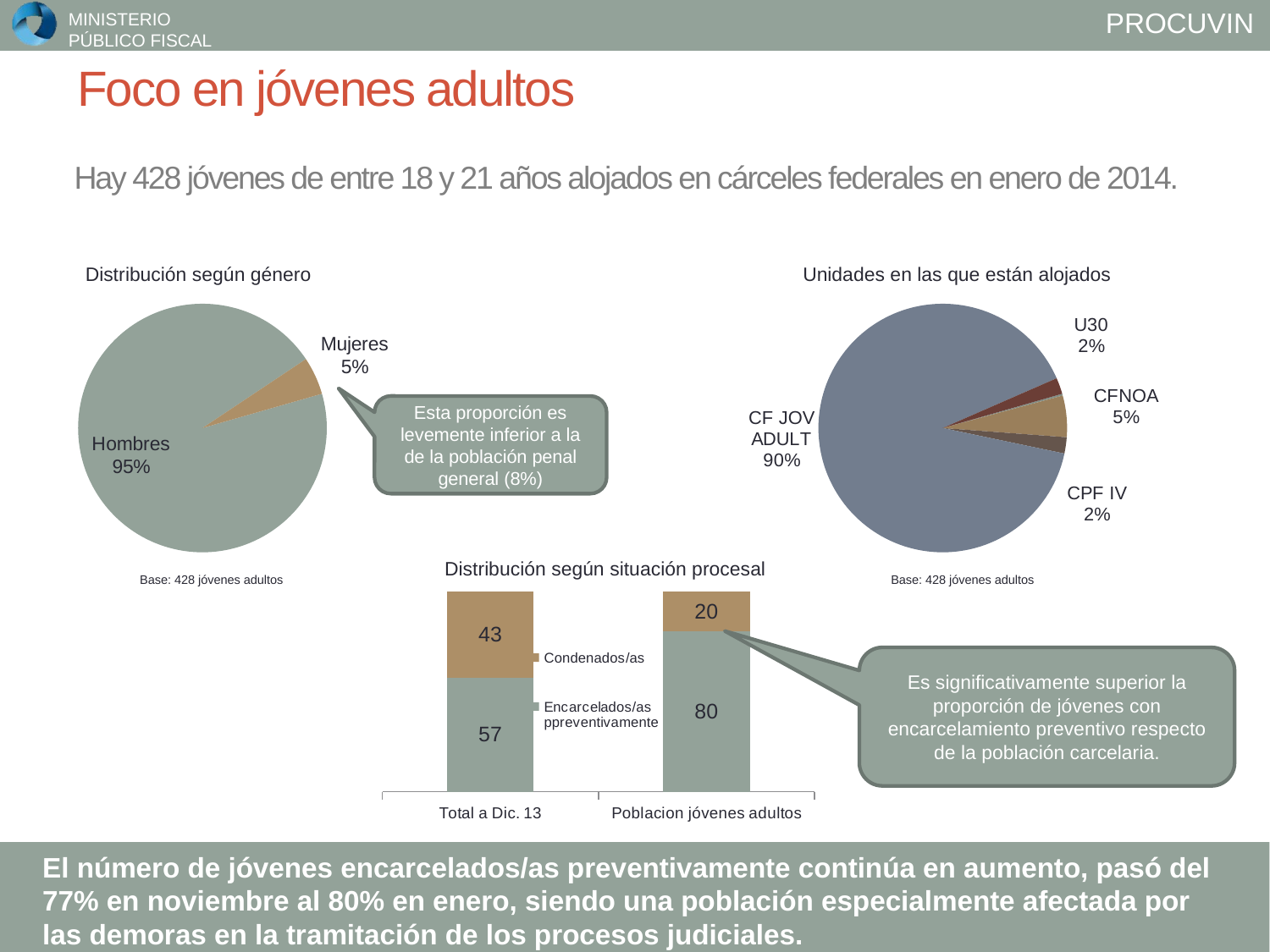
In the 'Distribución según situación procesal' chart, how many series does the legend list? 2 In the 'Unidades en las que están alojados' chart, what is the value for CFNOA? 5% What kind of chart is 'Distribución según género'? Pie chart In the 'Unidades en las que están alojados' chart, what is the value for CF JOV ADULT? 90% In the 'Distribución según situación procesal' chart, what is the total of the 'Total a Dic. 13' stacked bar? 100 In the 'Unidades en las que están alojados' chart, which unit has the largest share? CF JOV ADULT In the 'Distribución según género' chart, what share of the pie is Hombres? 95% In the 'Distribución según situación procesal' chart, what is the difference between the Encarcelados/as preventivamente values for 'Poblacion jóvenes adultos' and 'Total a Dic. 13'? 23 In the 'Distribución según género' chart, what is the value for Mujeres? 5% In the 'Distribución según situación procesal' chart, what is the value for Condenados/as in the 'Total a Dic. 13' bar? 43 In the 'Distribución según situación procesal' chart, what is the value for Encarcelados/as preventivamente in the 'Poblacion jóvenes adultos' bar? 80